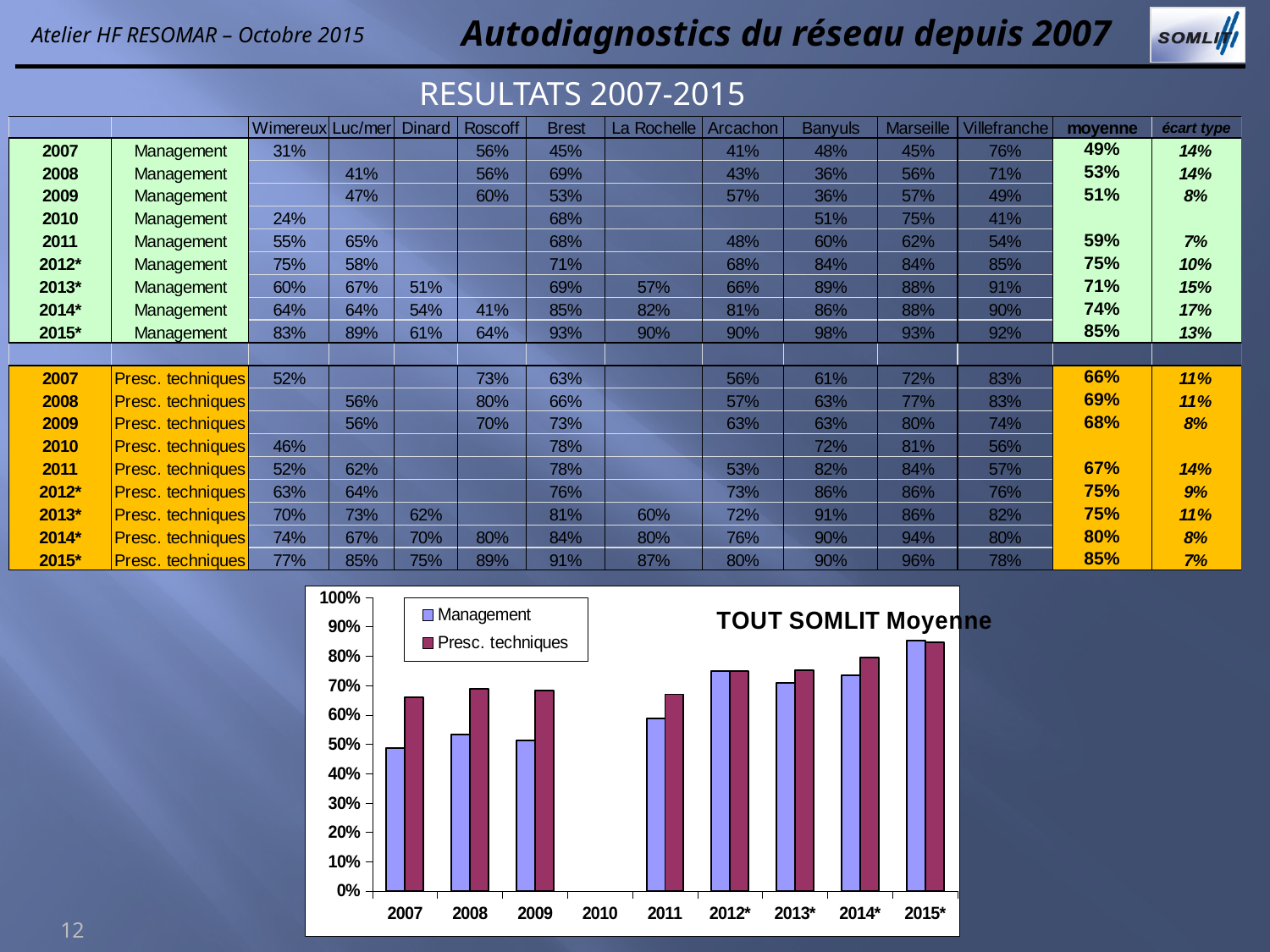
In the TOUT SOMLIT Moyenne chart, which year has the highest Management value? 2015* Which year on the x axis of the TOUT SOMLIT Moyenne chart has no bars plotted? 2010 In the TOUT SOMLIT Moyenne chart, is the Management value for 2015* greater or less than 80%? greater In the TOUT SOMLIT Moyenne chart, which year has the highest Presc. techniques value? 2015* In the TOUT SOMLIT Moyenne chart, is the Presc. techniques value for 2014* greater or less than 70%? greater How many series does the legend of the TOUT SOMLIT Moyenne chart list? 2 In the TOUT SOMLIT Moyenne chart, do the Management values generally rise or fall from 2007 to 2015*? rise In the TOUT SOMLIT Moyenne chart, which series has the larger value in 2007, Management or Presc. techniques? Presc. techniques In the TOUT SOMLIT Moyenne chart, is the Management value for 2011 greater or less than 70%? less What kind of chart is shown at the bottom of the slide? bar chart How many year categories are shown on the x axis of the TOUT SOMLIT Moyenne chart? 9